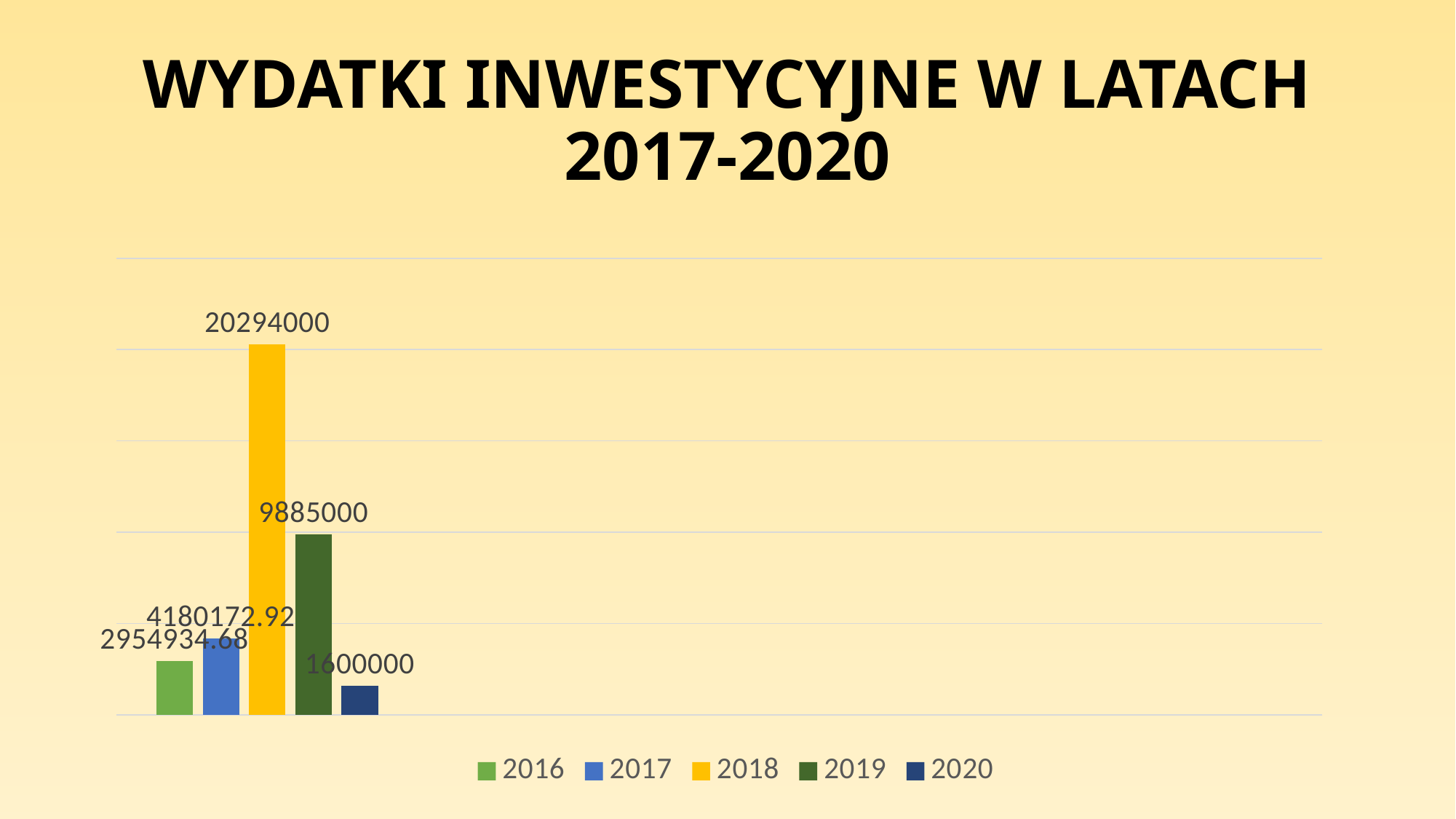
What is the value shown for 2020? 1600000 How many series does the legend list? 5 What is the difference between the values for 2019 and 2020? 8285000 What is the value shown for 2017? 4180172.92 What kind of chart is shown on the slide? bar chart Do the values rise or fall from 2018 to 2020? fall What is the difference between the values for 2018 and 2019? 10409000 What is the value shown for 2018? 20294000 What is the value shown for 2016? 2954934.68 Which year has the highest value? 2018 Which year has the lowest value? 2020 Which is larger, the value for 2017 or the value for 2016? 2017